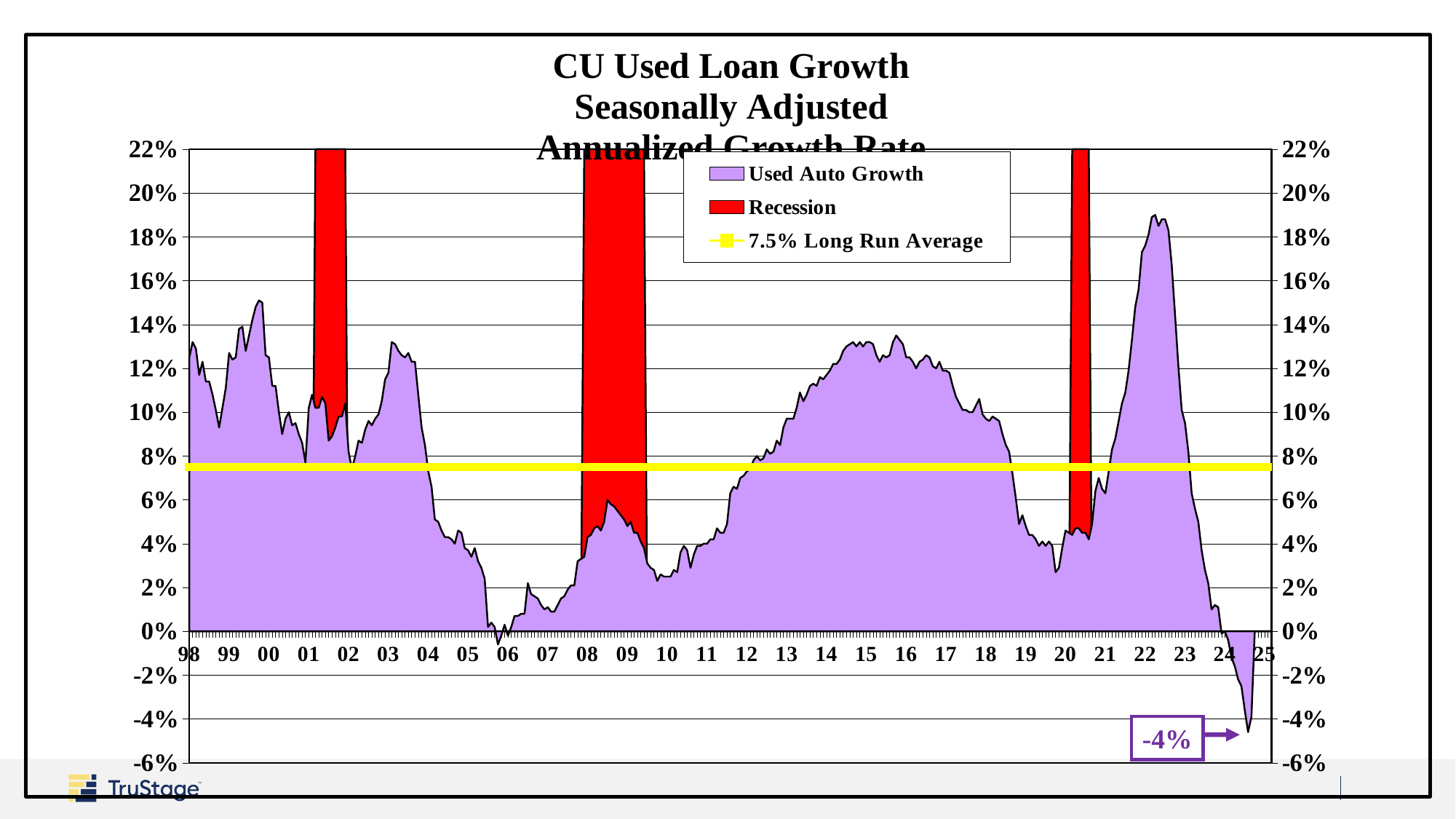
How many recession periods are shaded on the chart? 3 What kind of chart is shown on the slide? area chart Which year shows the highest peak in Used Auto Growth, 1999 or 2022? 2022 What is the value of the long run average line shown in the legend? 7.5% Is the Used Auto Growth value at its 2022 peak greater or less than 16%? greater Is the Used Auto Growth value in 2015 greater or less than 10%? greater How many series does the legend list? 3 Does Used Auto Growth rise or fall between 2022 and 2024? fall What colour is used for the Recession series? red Is the Used Auto Growth value in 2006 greater or less than 2%? less What is the most recent labeled value of Used Auto Growth at the end of the chart? -4%